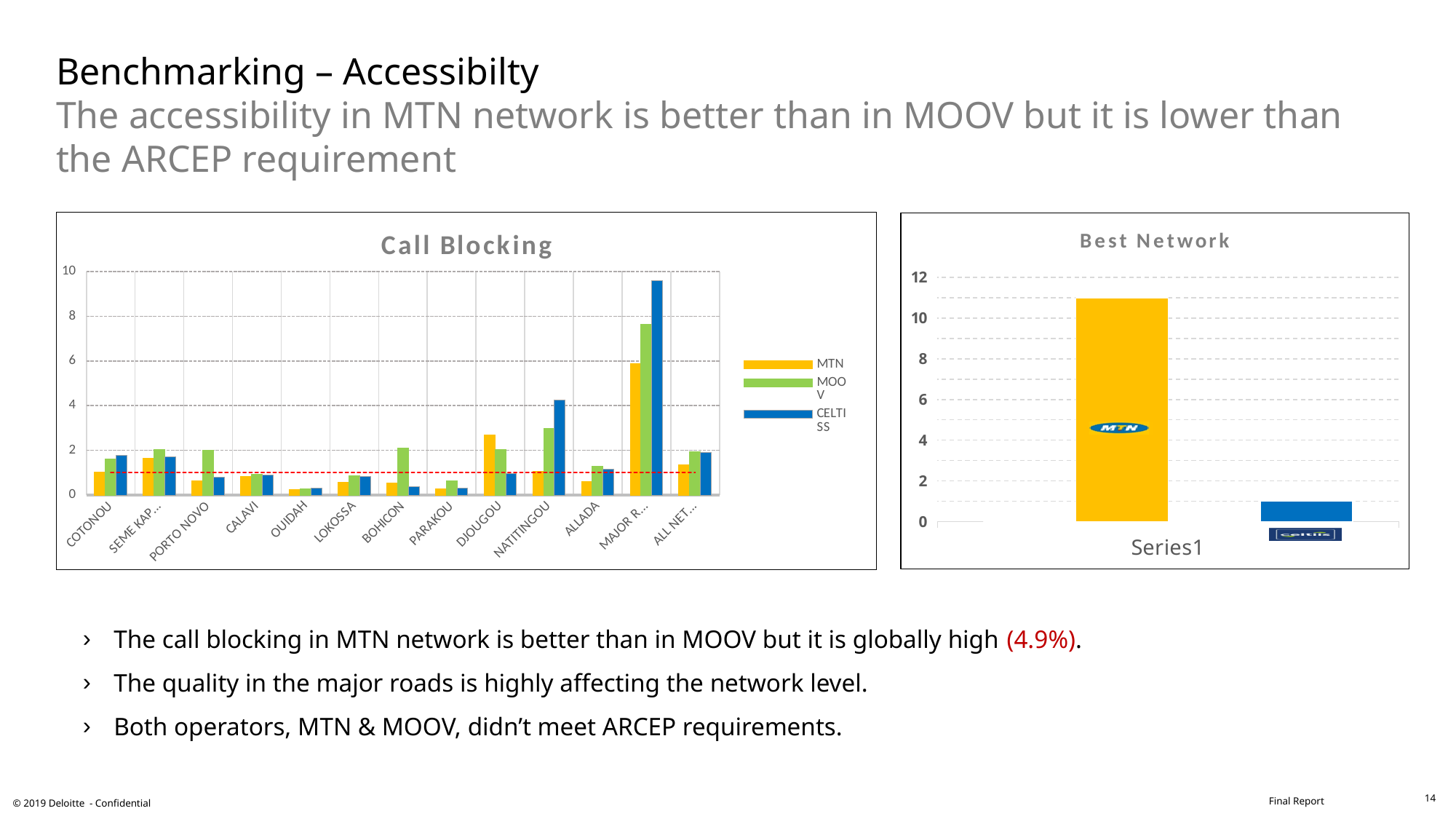
How many categories are shown on the x axis of the Call Blocking chart? 13 How many series does the legend of the Call Blocking chart list? 3 What are the three legend entries of the Call Blocking chart? MTN, MOOV, CELTISS In the Call Blocking chart, which series has the tallest bar overall? CELTISS In the Call Blocking chart, which is larger for NATITINGOU: the MTN bar or the CELTISS bar? CELTISS In the Call Blocking chart, is the CELTISS value for MAJOR R... greater or less than 8? greater In the Call Blocking chart, which is larger for DJOUGOU: the MTN bar or the CELTISS bar? MTN In the Call Blocking chart, is the MOOV value for MAJOR R... greater or less than 6? greater In the Best Network chart, is the MTN bar greater or less than 10? greater What kind of chart is the Call Blocking chart? bar chart In the Best Network chart, which operator has the taller bar? MTN